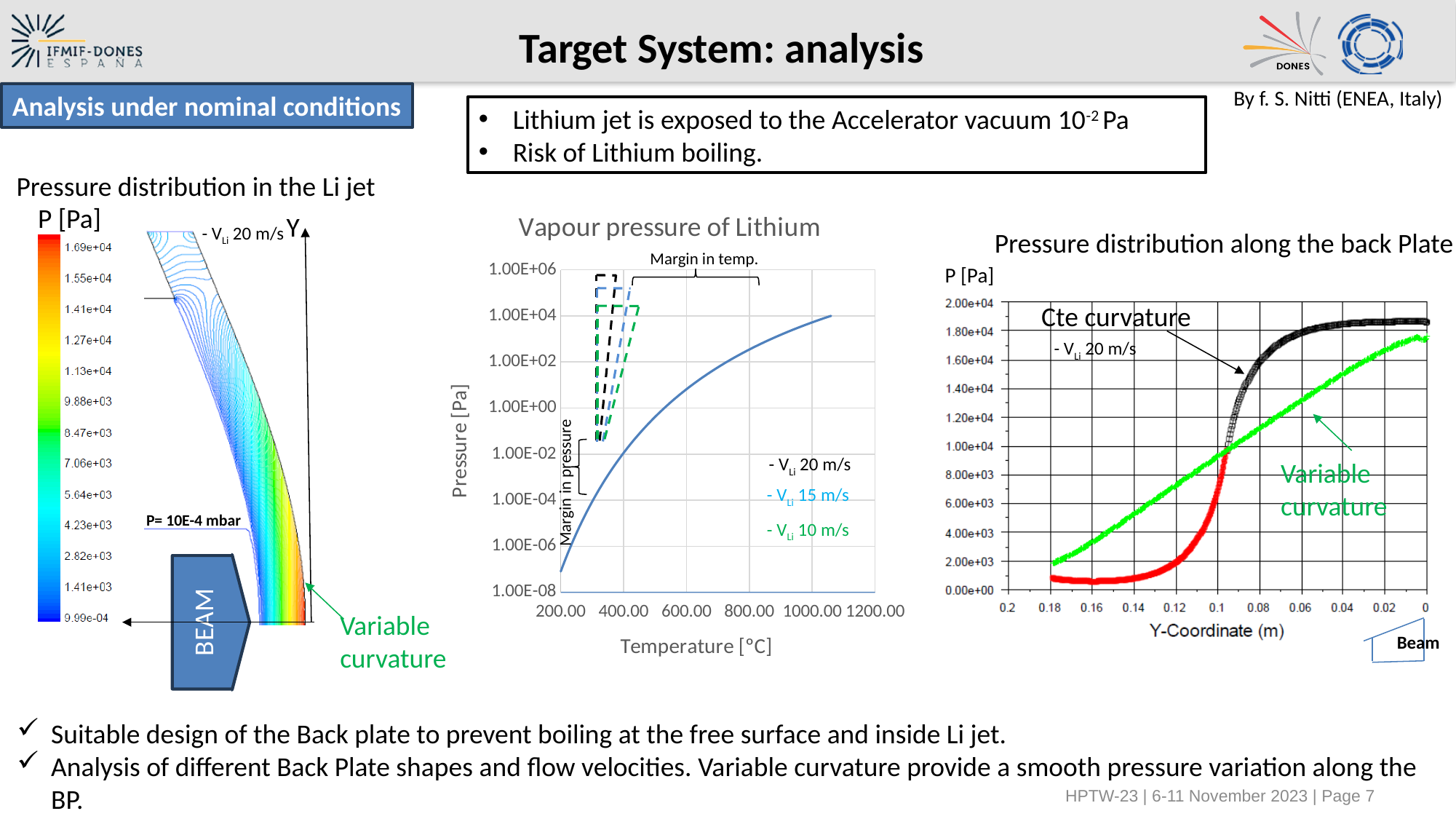
How many lithium velocities (V_Li) are listed as labels in the 'Vapour pressure of Lithium' chart? 3 What is the x-axis label of the 'Vapour pressure of Lithium' chart? Temperature [°C] In the 'Pressure distribution in the Li jet' plot, what is the maximum pressure value shown on the colour scale? 1.69e+04 In the 'Vapour pressure of Lithium' chart, does the vapour pressure rise or fall as temperature increases? rises In the 'Vapour pressure of Lithium' chart, what is the highest value shown on the pressure axis? 1.00E+06 In the 'Pressure distribution along the back Plate' chart, which curve has the higher pressure at Y-Coordinate 0.14 m, Cte curvature or Variable curvature? Variable curvature In the 'Pressure distribution along the back Plate' chart, is the Cte curvature pressure at Y-Coordinate 0.16 m greater or less than 2.00e+03 Pa? less In the 'Pressure distribution in the Li jet' plot, what is the minimum pressure value shown on the colour scale? 9.99e-04 What kind of chart is the 'Vapour pressure of Lithium' chart? line chart In the 'Pressure distribution along the back Plate' chart, is the Cte curvature pressure at Y-Coordinate 0.02 m greater or less than 1.80e+04 Pa? greater In the 'Pressure distribution along the back Plate' chart, what is the label of the x axis? Y-Coordinate (m) In the 'Pressure distribution along the back Plate' chart, is the Variable curvature pressure at Y-Coordinate 0.16 m greater or less than 2.00e+03 Pa? greater